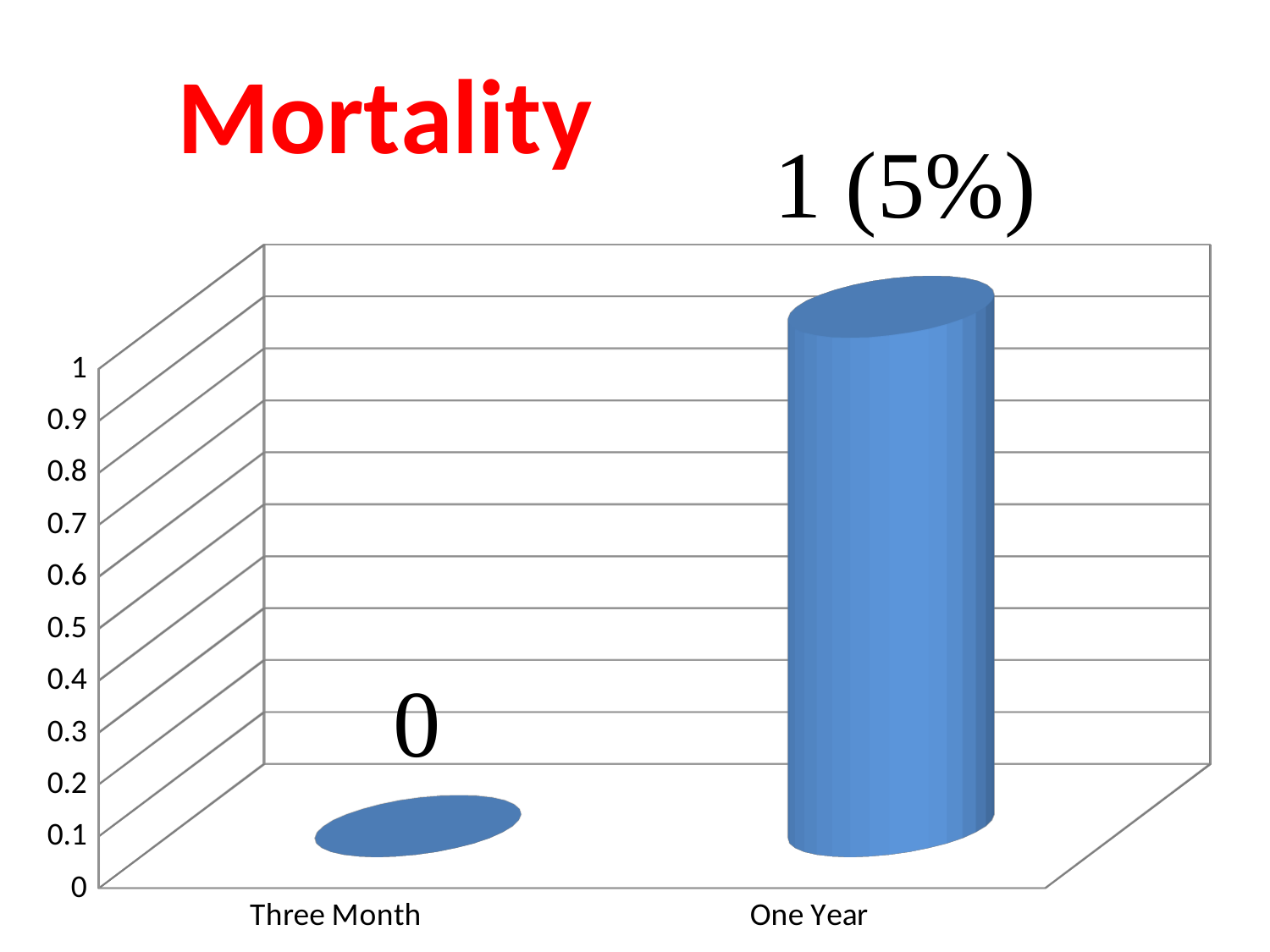
Do the values rise or fall from Three Month to One Year? rise What is the data label shown above the One Year bar? 1 (5%) What kind of chart is shown on the slide? bar chart How many categories are shown on the x axis of the chart? 2 Is the value for One Year greater or less than 0.5? greater Which category has the lowest mortality value? Three Month Is the mortality value for One Year larger or smaller than the value for Three Month? larger What is the maximum value shown on the vertical axis? 1 What is the difference between the One Year mortality count and the Three Month mortality count? 1 Which category has the higher mortality value? One Year What is the mortality value shown for Three Month? 0 What is the title of the chart? Mortality